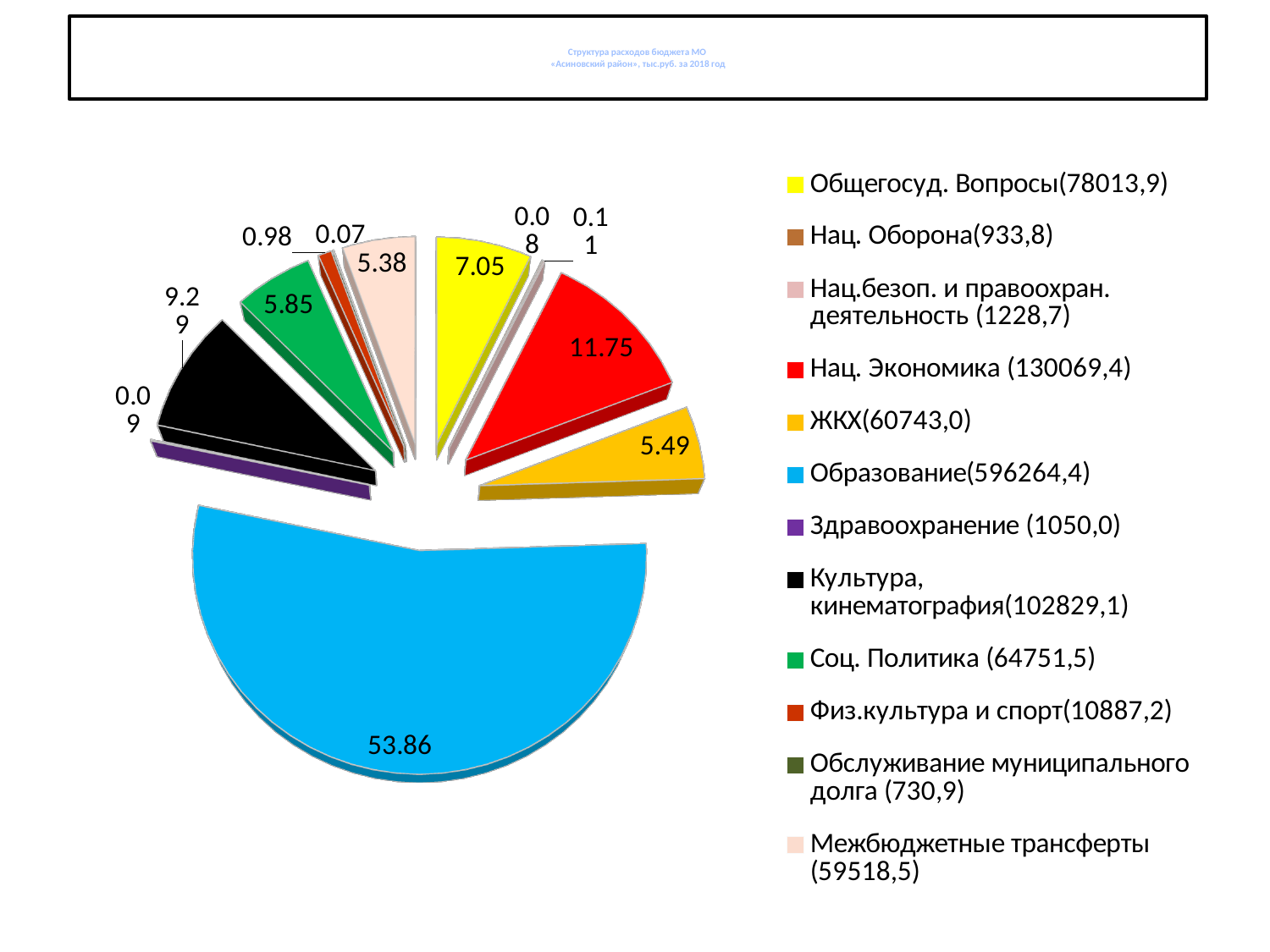
What value is labelled on the Общегосуд. Вопросы slice? 7.05 What kind of chart is shown on the slide? Pie chart Which category has the smallest labelled share in the pie chart? Обслуживание муниципального долга What is the difference between the labelled shares of Соц. Политика and Межбюджетные трансферты? 0.47 What amount is given in the legend for Образование? 596264,4 What value is labelled on the ЖКХ slice? 5.49 Which slice is larger, Нац. Экономика or ЖКХ? Нац. Экономика What percentage share is shown for Образование in the pie chart? 53.86 Which category has the largest slice in the pie chart? Образование What value is labelled on the Нац. Экономика slice of the pie chart? 11.75 What value is labelled on the Соц. Политика slice? 5.85 How many categories does the legend of the pie chart list? 12